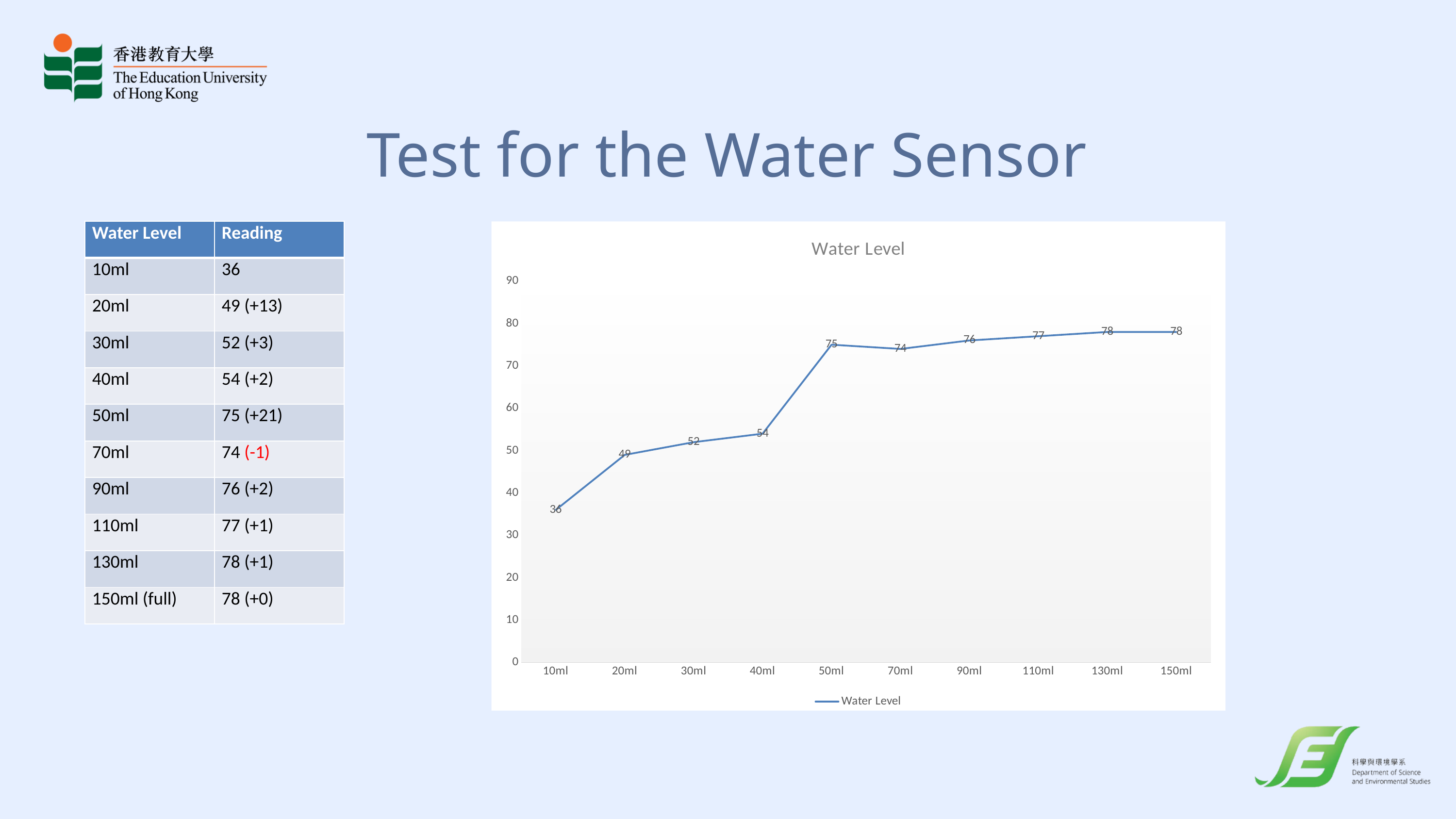
What kind of chart is shown on the slide? line chart How many series does the chart legend list? 1 Do the readings generally rise or fall from 10ml to 150ml? rise Which has the larger reading, 20ml or 40ml? 40ml How many water level points are plotted in the chart? 10 Is the reading for 30ml greater or less than 60? less What is the title of the chart? Water Level What is the reading for 50ml in the Water Level chart? 75 What is the reading for 70ml in the Water Level chart? 74 What is the difference between the readings at 50ml and 40ml? 21 What is the reading for 10ml in the Water Level chart? 36 Which water level has the lowest reading in the chart? 10ml